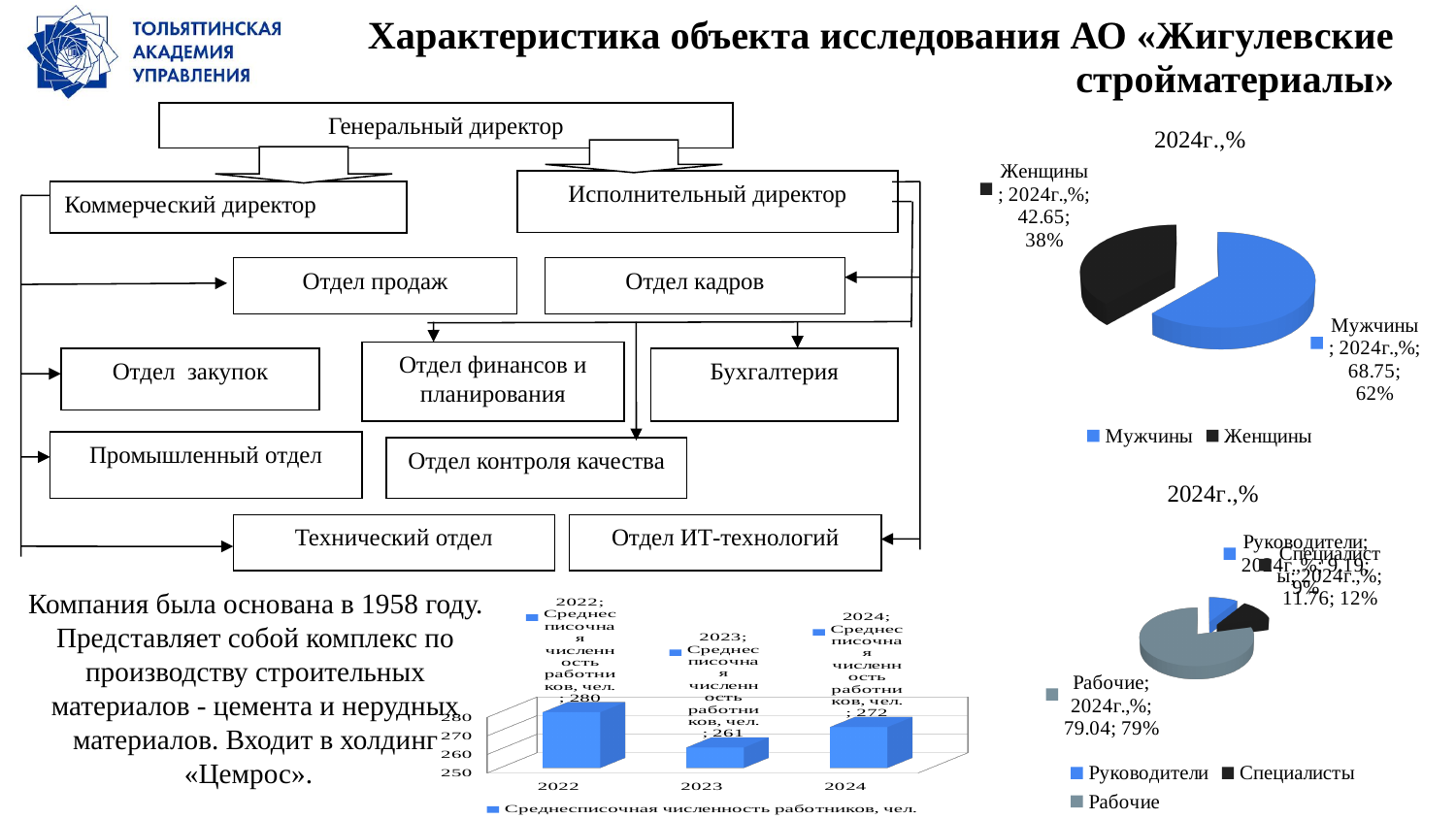
In the top-right pie chart (2024г.,%), which category is larger, Мужчины or Женщины? Мужчины In the bar chart at the bottom of the slide, what is the difference between the 2022 and 2023 values? 19 In the bar chart at the bottom of the slide, what is the value for 2023? 261 In the bar chart at the bottom of the slide, what is the value for 2024? 272 What type of chart is used at the bottom of the slide for Среднесписочная численность работников? bar chart In the bottom-right pie chart (2024г.,%), what share of the pie is Специалисты? 12% In the bar chart at the bottom of the slide, which year has the highest headcount? 2022 In the bar chart at the bottom of the slide, how many years are shown? 3 In the top-right pie chart (2024г.,%), what share of the pie is Мужчины? 62% In the bar chart at the bottom of the slide, what is the average headcount (Среднесписочная численность работников) for 2022? 280 In the bottom-right pie chart (2024г.,%), which category has the largest share? Рабочие In the bar chart at the bottom of the slide, which year has the lowest headcount? 2023